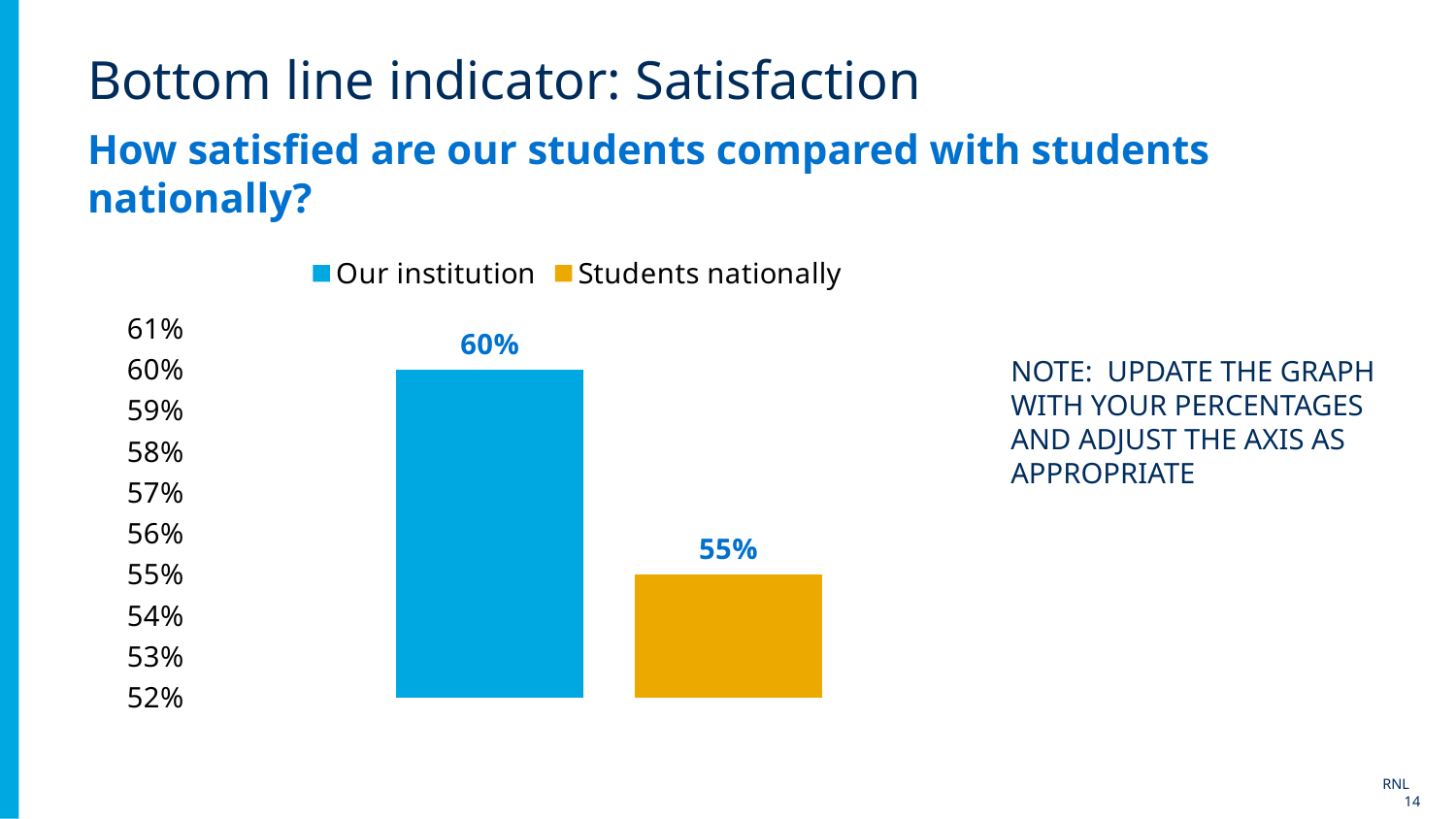
What is the lowest value shown on the vertical axis? 52% What is the value for Students nationally? 55% What colour is the bar for Students nationally? Yellow Is the value for Students nationally greater or less than 57%? less What is the difference between the value for Our institution and the value for Students nationally? 5% What is the value for Our institution? 60% Which series has the lowest value? Students nationally Is the value for Our institution greater or less than 58%? greater How many series does the legend list? 2 Which series has the higher value, Our institution or Students nationally? Our institution What kind of chart is shown on the slide? Bar chart How many bars are plotted in the chart? 2